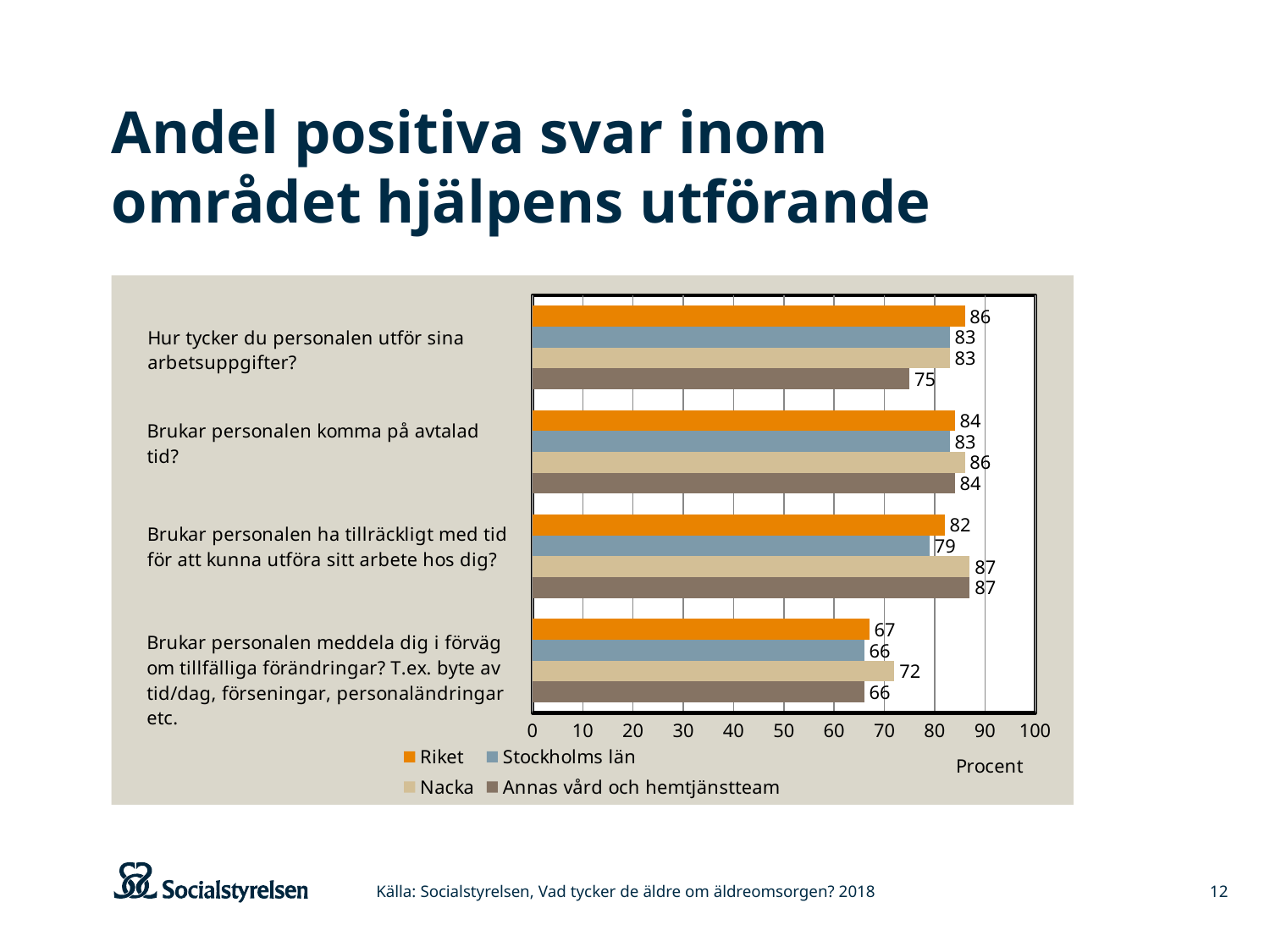
Which is larger for "Brukar personalen meddela dig i förväg om tillfälliga förändringar?": Riket or Nacka? Nacka Which series has the highest value for "Brukar personalen meddela dig i förväg om tillfälliga förändringar?"? Nacka What is the value for Riket for "Hur tycker du personalen utför sina arbetsuppgifter?"? 86 Which series has the lowest value for "Hur tycker du personalen utför sina arbetsuppgifter?"? Annas vård och hemtjänstteam What type of chart is shown on the slide? Bar chart What is the value for Nacka for "Brukar personalen komma på avtalad tid?"? 86 What is the value for Stockholms län for "Brukar personalen ha tillräckligt med tid för att kunna utföra sitt arbete hos dig?"? 79 What is the label on the horizontal axis of the chart? Procent What is the difference between Nacka and Riket for "Brukar personalen ha tillräckligt med tid för att kunna utföra sitt arbete hos dig?"? 5 How many question categories are shown on the chart? 4 How many series does the legend list? 4 What is the value for Annas vård och hemtjänstteam for "Hur tycker du personalen utför sina arbetsuppgifter?"? 75